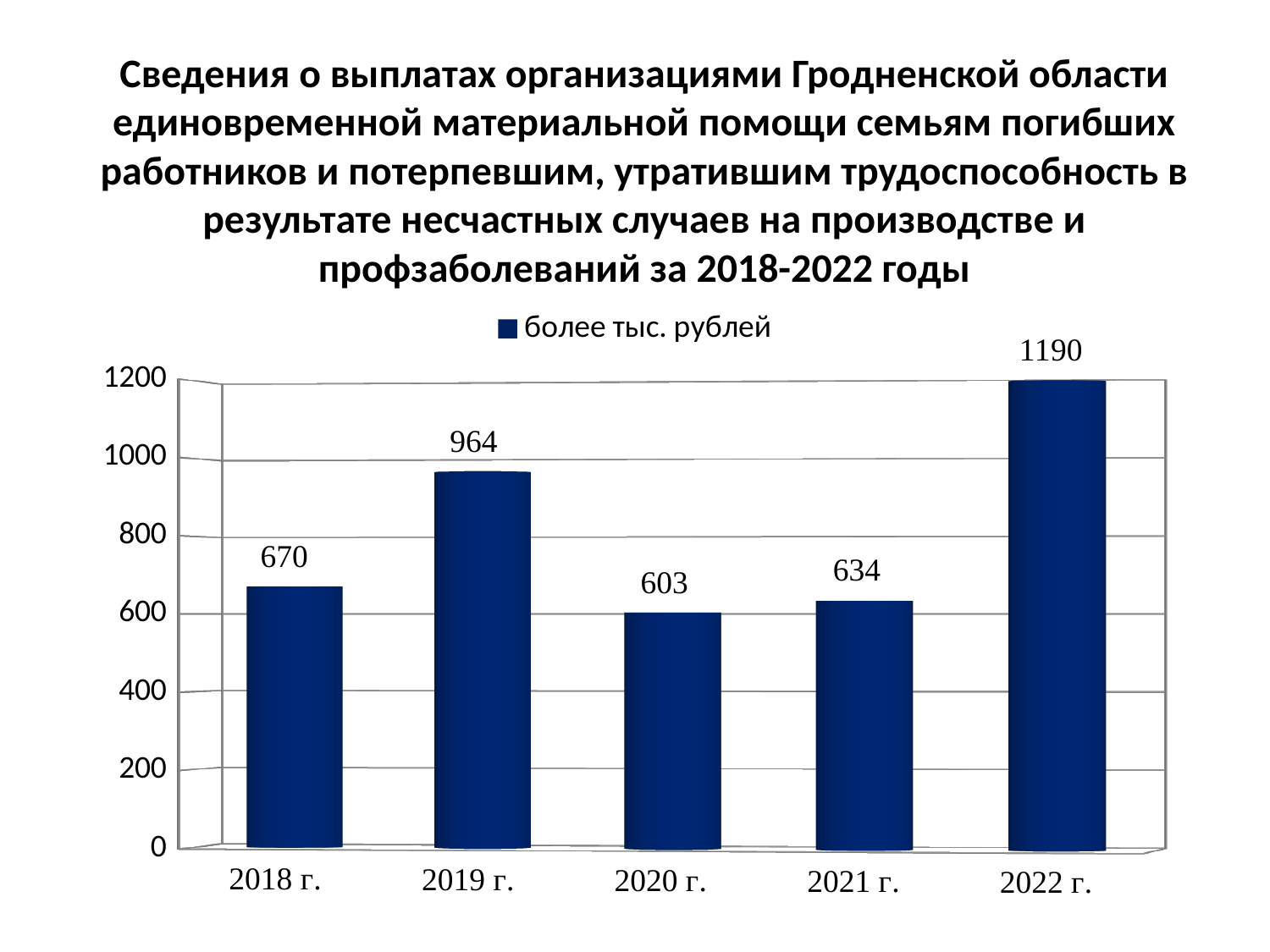
Is the value for 2019 г. greater or less than 1000? less What is the value for 2022 г.? 1190 What is the value for 2020 г.? 603 What is the legend entry for the series? более тыс. рублей What is the difference between the values for 2021 г. and 2020 г.? 31 Which is larger, the value for 2018 г. or the value for 2021 г.? 2018 г. Which year has the highest value? 2022 г. Which year has the lowest value? 2020 г. What is the difference between the values for 2022 г. and 2019 г.? 226 What is the value for 2018 г.? 670 What kind of chart is shown on the slide? bar chart How many years are shown on the x axis? 5